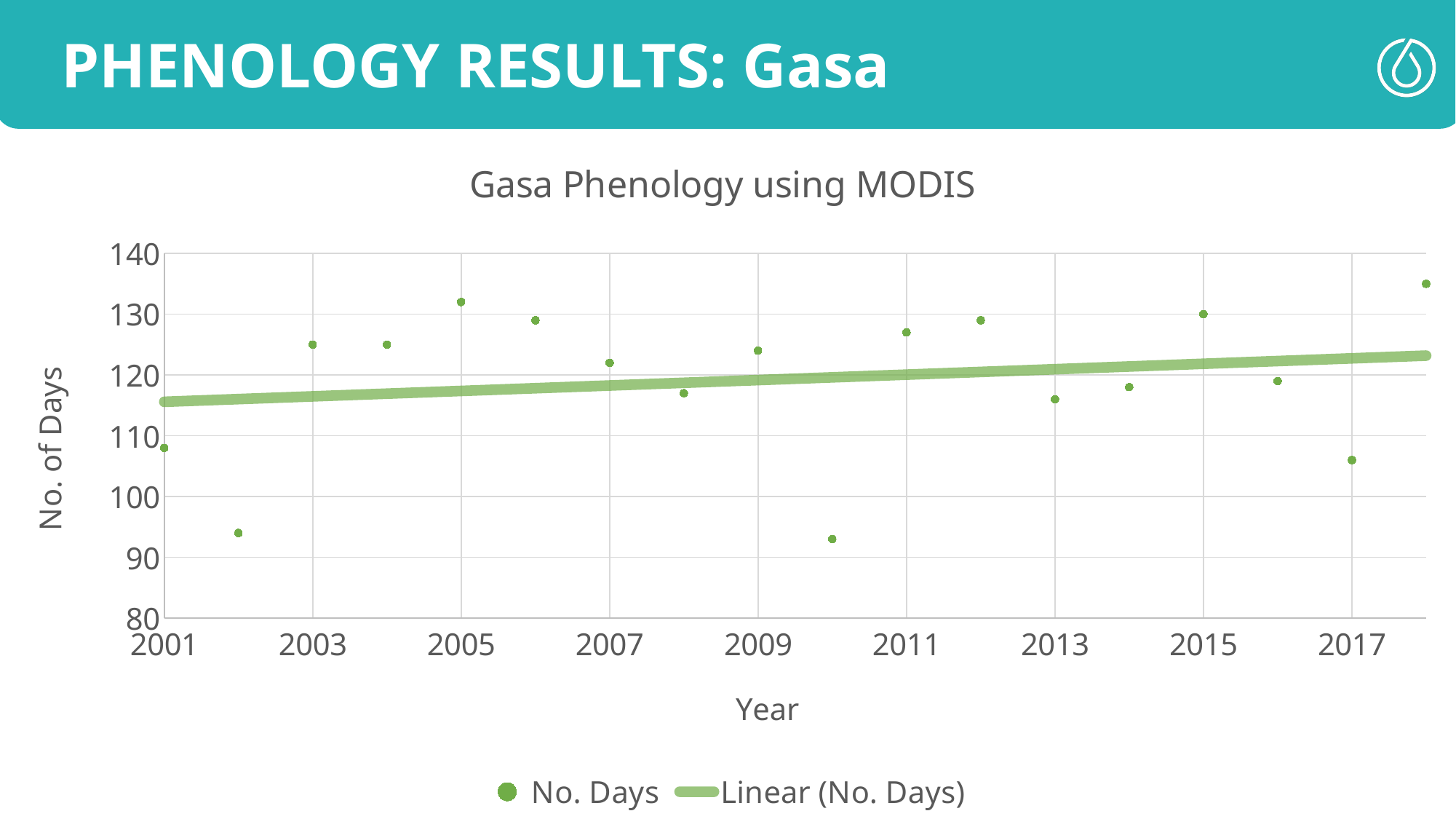
Is the value for No. Days in 2002 greater or less than 100? less Is the value for No. Days in 2005 greater or less than 130? greater Is the value for No. Days in 2010 greater or less than 100? less Which year has the larger No. Days value, 2005 or 2002? 2005 Does the linear trendline rise or fall from 2001 to 2018? Rises What is the label of the y axis? No. of Days How many data points are plotted for No. Days? 18 How many series does the legend list? 2 What kind of chart is shown on the slide? Scatter chart What is the title of the chart? Gasa Phenology using MODIS